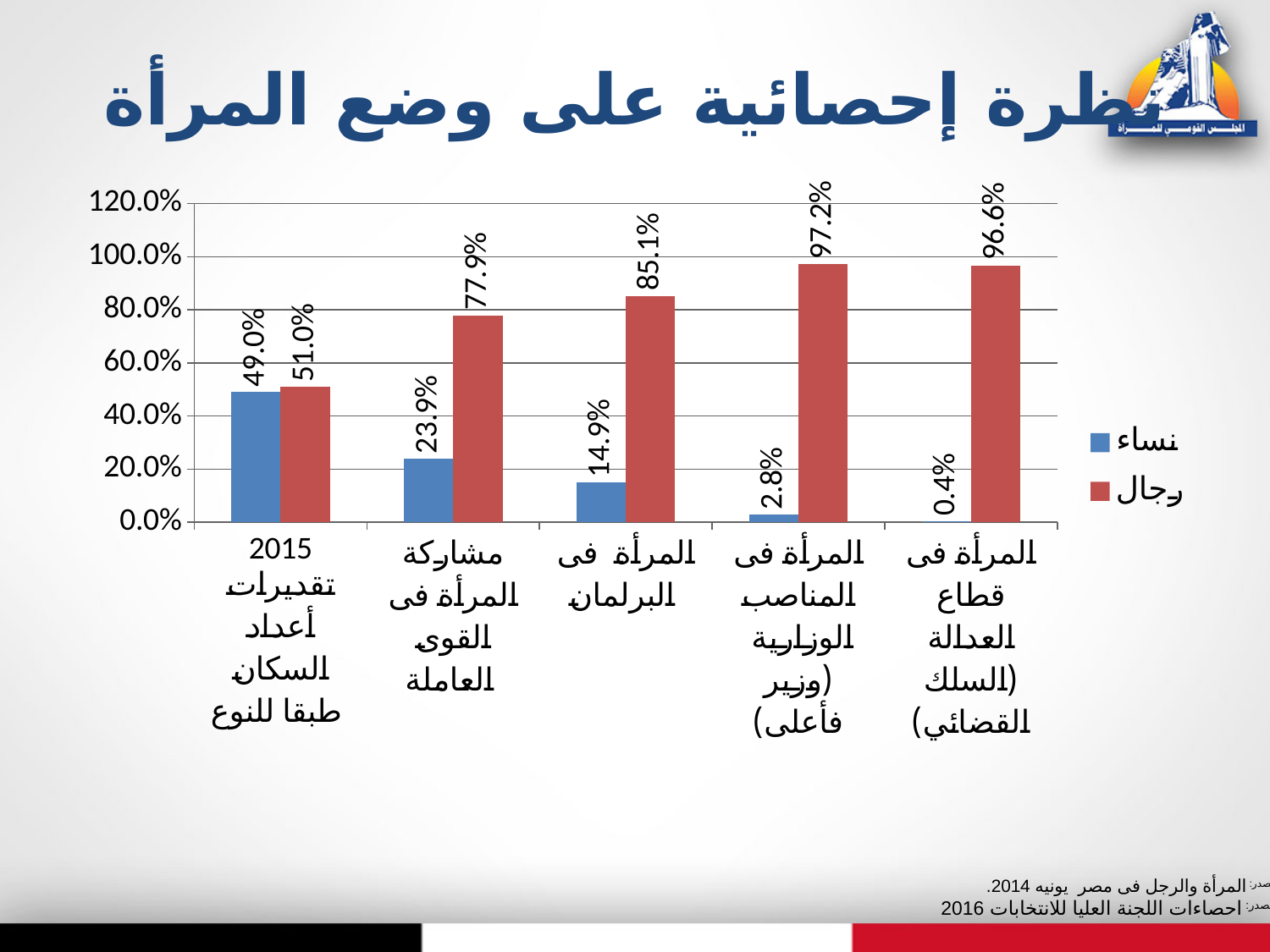
What is the value for نساء (women) in the category المرأة في البرلمان? 14.9% What type of chart is shown on the slide? Bar chart What is the difference between the رجال (men) and نساء (women) values in the category المرأة في البرلمان? 70.2% What is the value for رجال (men) in the category المرأة في المناصب الوزارية (وزير فأعلى)? 97.2% Which colour represents the series رجال (men) in the chart? Red Which is larger: the نساء (women) value for مشاركة المرأة في القوى العاملة or the نساء (women) value for المرأة في البرلمان? مشاركة المرأة في القوى العاملة How many categories are shown on the x axis of the chart? 5 What is the value for رجال (men) in the category مشاركة المرأة في القوى العاملة? 77.9% In which category is the نساء (women) value highest? تقديرات أعداد السكان طبقا للنوع 2015 In which category is the نساء (women) value lowest? المرأة في قطاع العدالة (السلك القضائي) What is the value for نساء (women) in the category المرأة في قطاع العدالة (السلك القضائي)? 0.4% How many series does the chart legend list? 2